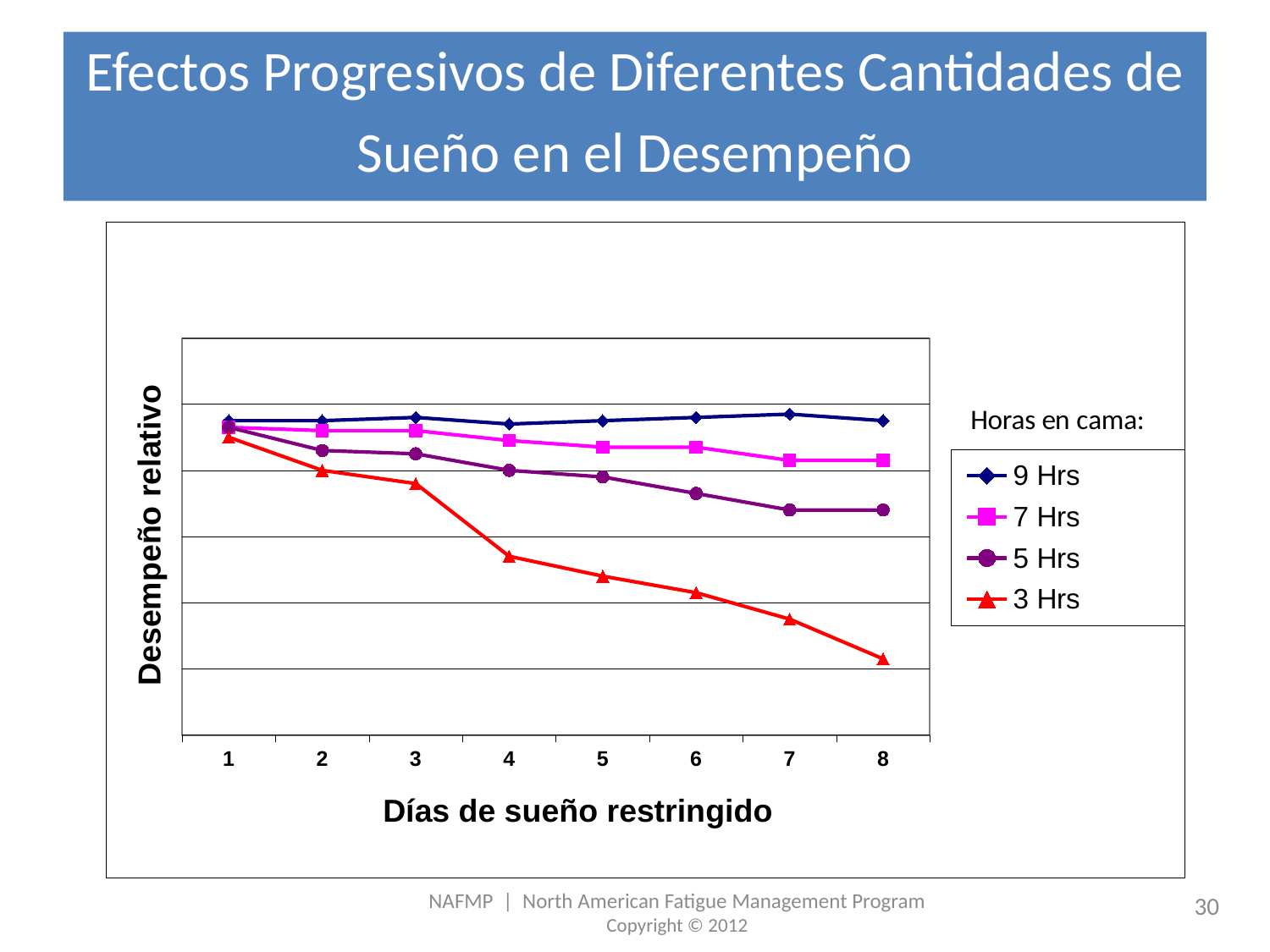
Which series shows the steepest decline over the eight days? 3 Hrs Does the relative performance for the 3 Hrs series rise or fall as the days of restricted sleep increase? Fall Which series has the lowest relative performance on day 8? 3 Hrs What kind of chart is shown on the slide? Line chart Does the relative performance for the 5 Hrs series rise or fall from day 1 to day 8? Fall On day 4, which series has the lower relative performance, 5 Hrs or 3 Hrs? 3 Hrs What is the title of the x axis of the chart? Días de sueño restringido Which series has the highest relative performance on day 8? 9 Hrs What heading appears above the legend entries? Horas en cama: On day 6, which series has the higher relative performance, 7 Hrs or 5 Hrs? 7 Hrs How many series does the legend list? 4 How many days of restricted sleep are plotted along the x axis? 8